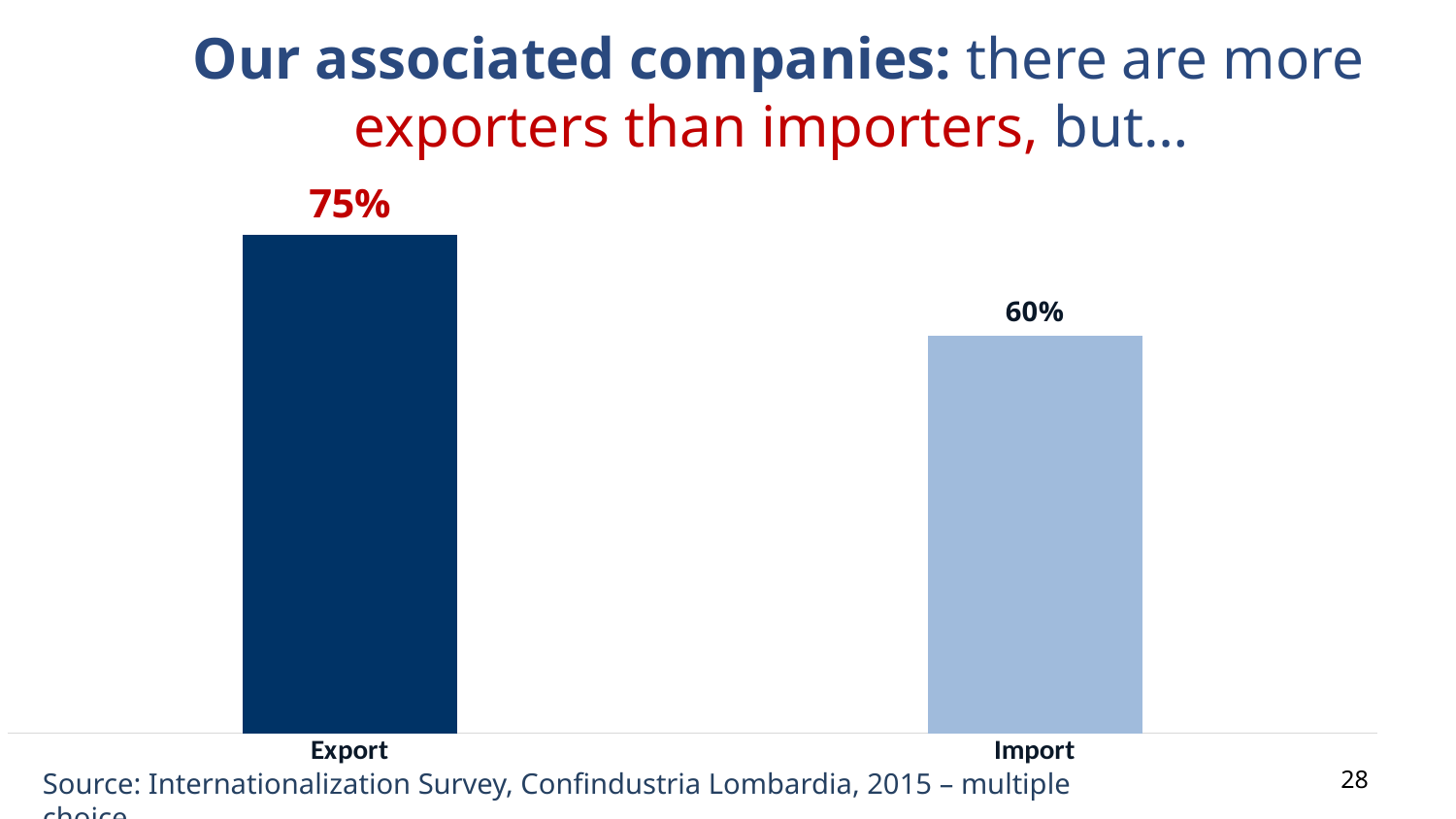
Which is larger, the value for Export or the value for Import? Export Do the values rise or fall from Export to Import? Fall Which category has the highest value? Export Which category has the lowest value? Import What is the value for Export? 75% How many categories are shown in the chart? 2 What kind of chart is shown on the slide? Bar chart What is the source cited for the chart data? Internationalization Survey, Confindustria Lombardia, 2015 Which bar is drawn in the darker blue colour? Export What is the difference between the Export and Import values? 15% What is the value for Import? 60%